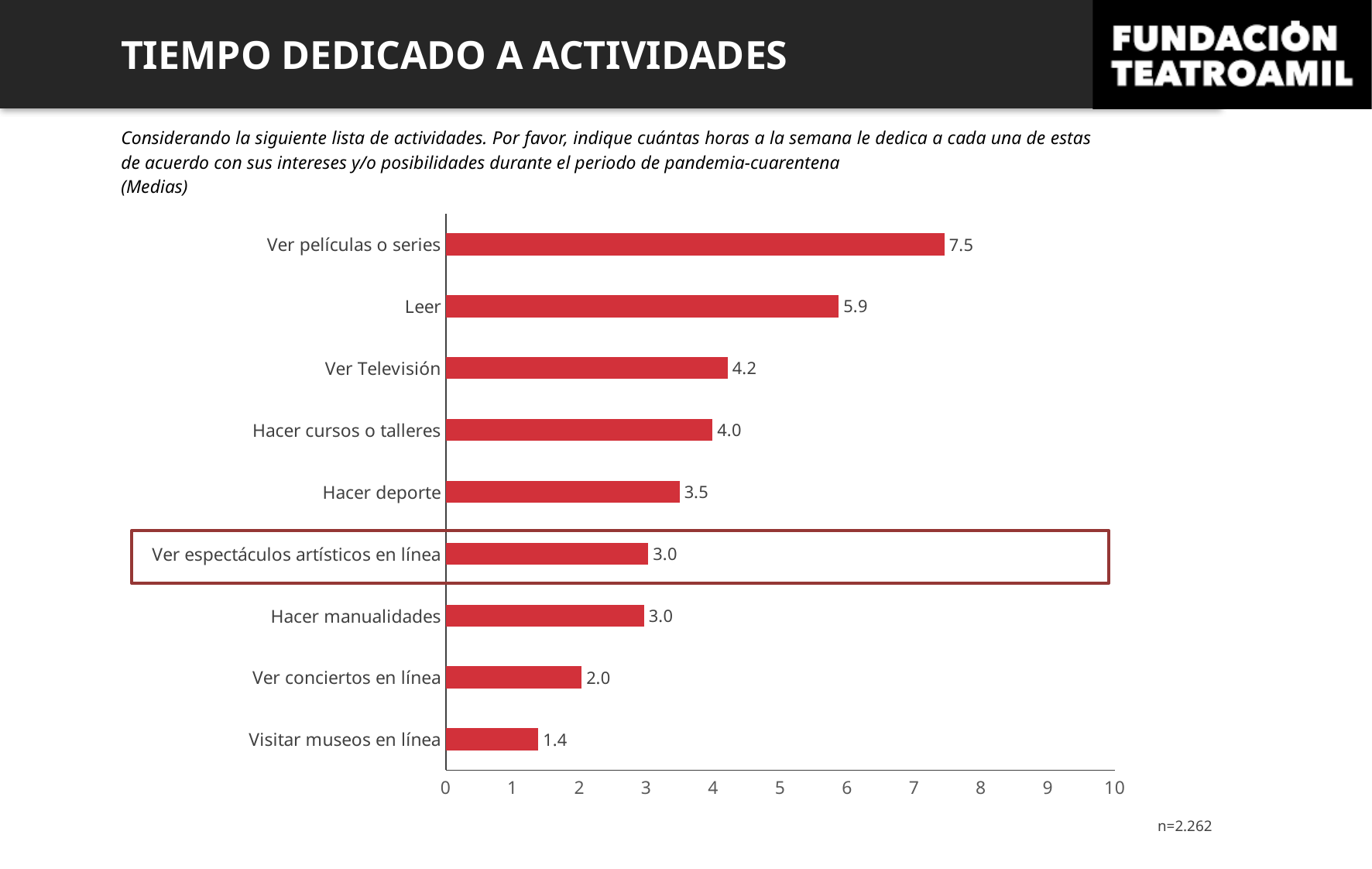
What kind of chart is shown on the slide? Bar chart What is the value for Ver películas o series? 7.5 What is the difference between the values for Ver películas o series and Leer? 1.6 How many activities are shown in the chart? 9 Which activity has the lowest value? Visitar museos en línea Which activity has the highest value? Ver películas o series Which is larger, the value for Hacer deporte or the value for Hacer cursos o talleres? Hacer cursos o talleres What is the value for Visitar museos en línea? 1.4 What is the value for Leer? 5.9 What is the difference between the values for Ver Televisión and Ver conciertos en línea? 2.2 Which activity is highlighted with a box on the chart? Ver espectáculos artísticos en línea What is the value for Ver espectáculos artísticos en línea? 3.0